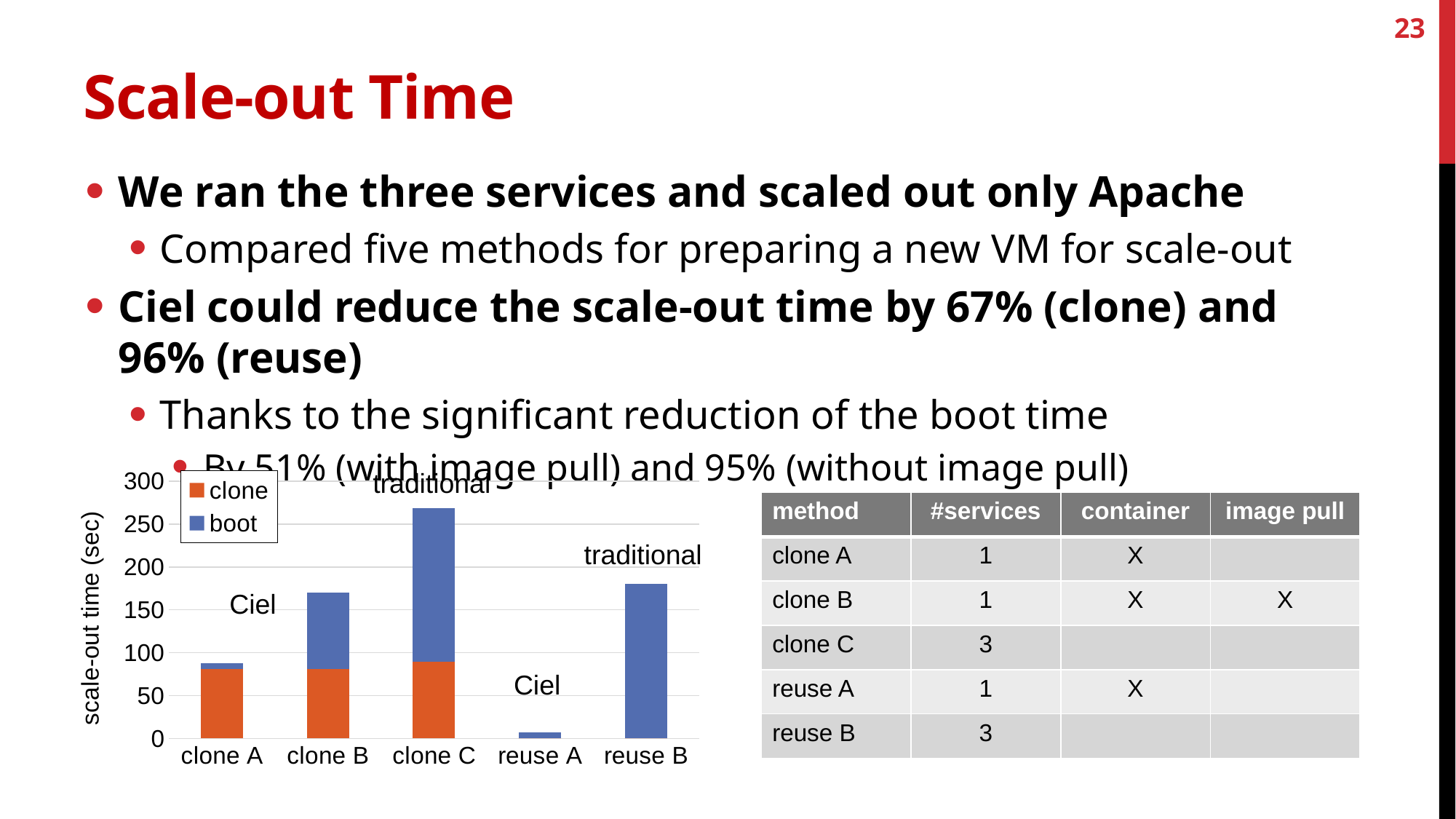
What kind of chart is shown on the slide? bar chart How many categories are shown on the x axis of the chart? 5 Which category has the highest total scale-out time? clone C Which has a larger total scale-out time, reuse B or reuse A? reuse B Which has a larger total scale-out time, clone B or clone A? clone B Is the total scale-out time for clone B greater or less than 150? greater Is the total scale-out time for clone A greater or less than 100? less How many series does the chart's legend list? 2 What is the label of the chart's y axis? scale-out time (sec) Is the total scale-out time for reuse A greater or less than 50? less Which category has the lowest total scale-out time? reuse A